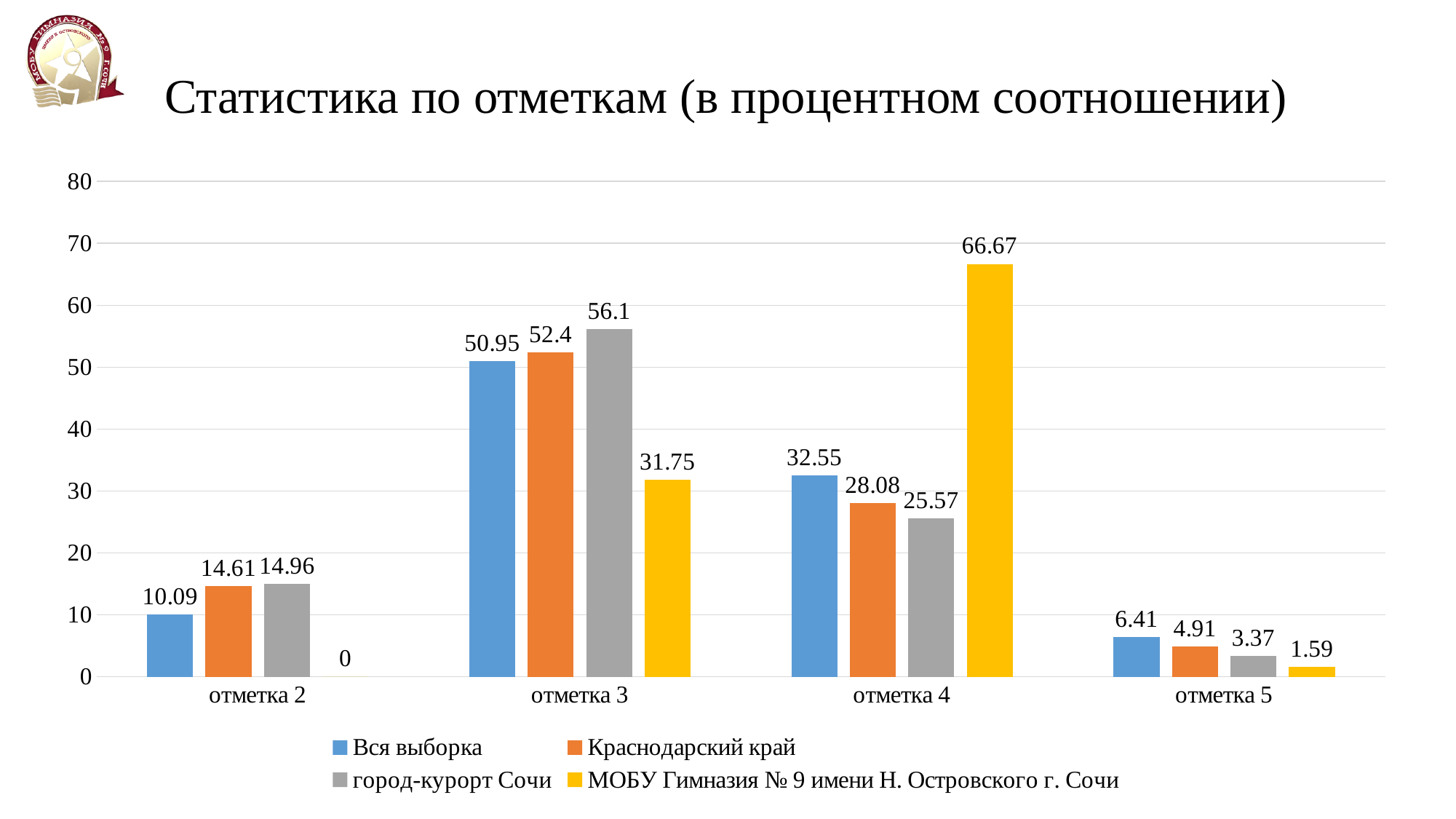
Which series has the highest value at отметка 4? МОБУ Гимназия № 9 имени Н. Островского г. Сочи What is the value for МОБУ Гимназия № 9 имени Н. Островского г. Сочи at отметка 4? 66.67 What is the difference between город-курорт Сочи and Вся выборка at отметка 3? 5.15 What is the value for Краснодарский край at отметка 5? 4.91 What is the value for город-курорт Сочи at отметка 2? 14.96 How many categories are shown on the x axis? 4 Which is larger at отметка 5: Вся выборка or город-курорт Сочи? Вся выборка How many series does the legend list? 4 What is the title of the chart? Статистика по отметкам (в процентном соотношении) What kind of chart is shown on the slide? bar chart What is the value for Вся выборка at отметка 3? 50.95 Which series has the lowest value at отметка 2? МОБУ Гимназия № 9 имени Н. Островского г. Сочи